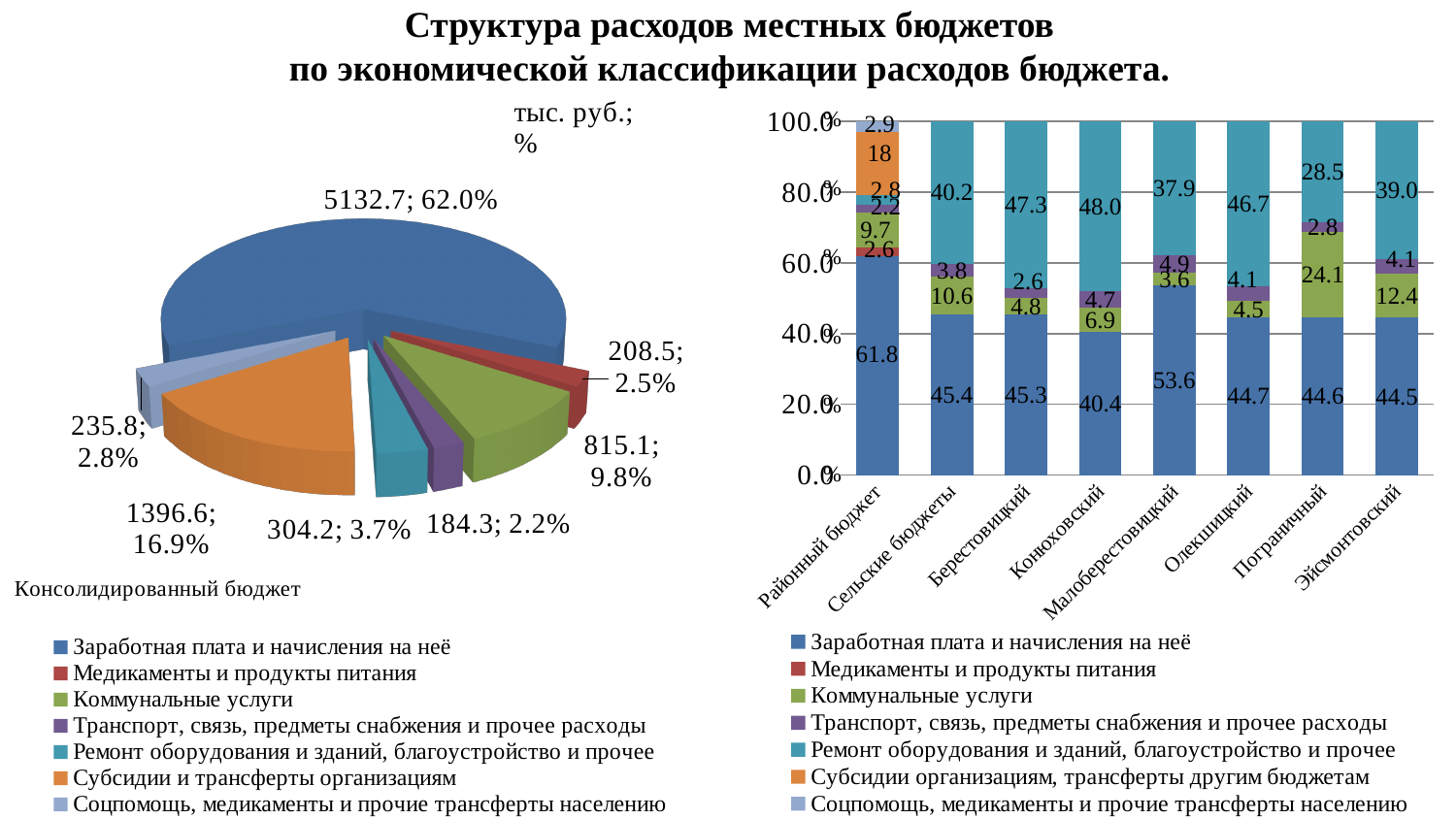
In the pie chart on the left, what is the difference between the values 815.1 and 208.5? 606.6 In the pie chart on the left, what share does the orange slice (Субсидии и трансферты организациям) have? 16.9% In the stacked bar chart on the right, what is the value of Заработная плата и начисления на неё for Малоберестовицкий? 53.6 In the pie chart on the left, what value is shown for the largest slice (Заработная плата и начисления на неё)? 5132.7; 62.0% In the stacked bar chart on the right, how many series does the legend list? 7 In the pie chart on the left, which category has the smallest slice? Транспорт, связь, предметы снабжения и прочее расходы In the stacked bar chart on the right, what is the value of Ремонт оборудования и зданий, благоустройство и прочее for Коноховский? 48.0 In the stacked bar chart on the right, how many categories are shown on the x axis? 8 In the stacked bar chart on the right, which category has the highest value for Заработная плата и начисления на неё? Районный бюджет In the stacked bar chart on the right, which is larger: the Коммунальные услуги value for Пограничный or for Эйсмонтовский? Пограничный In the pie chart on the left, how many slices are there? 7 What type of chart is shown on the right side of the slide? Stacked bar chart